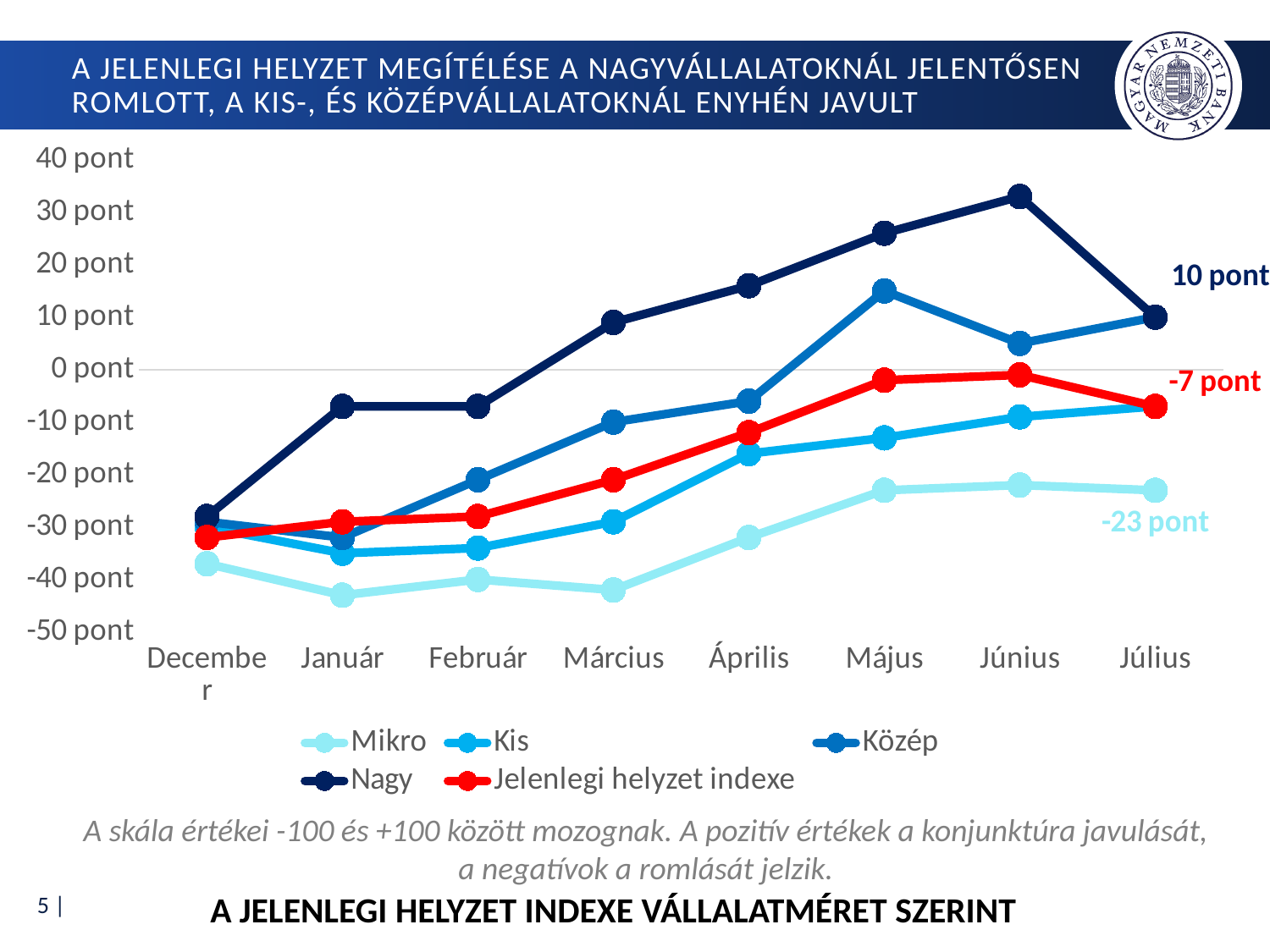
Is the value for Nagy in Május greater or less than 20 pont? greater How many series does the legend list? 5 In Május, which is larger: the Nagy value or the Mikro value? Nagy Which series has the highest value in Június? Nagy Is the value for Kis in Január greater or less than -30 pont? less What is the value of the Mikro series in Július? -23 pont What is the value of the Jelenlegi helyzet indexe series in Július? -7 pont How many months are shown on the x axis? 8 What kind of chart is shown on the slide? line chart What is the value of the Nagy series in Július? 10 pont Which series has the lowest value in Július? Mikro In Július, what is the difference between the Nagy value and the Jelenlegi helyzet indexe value? 17 pont